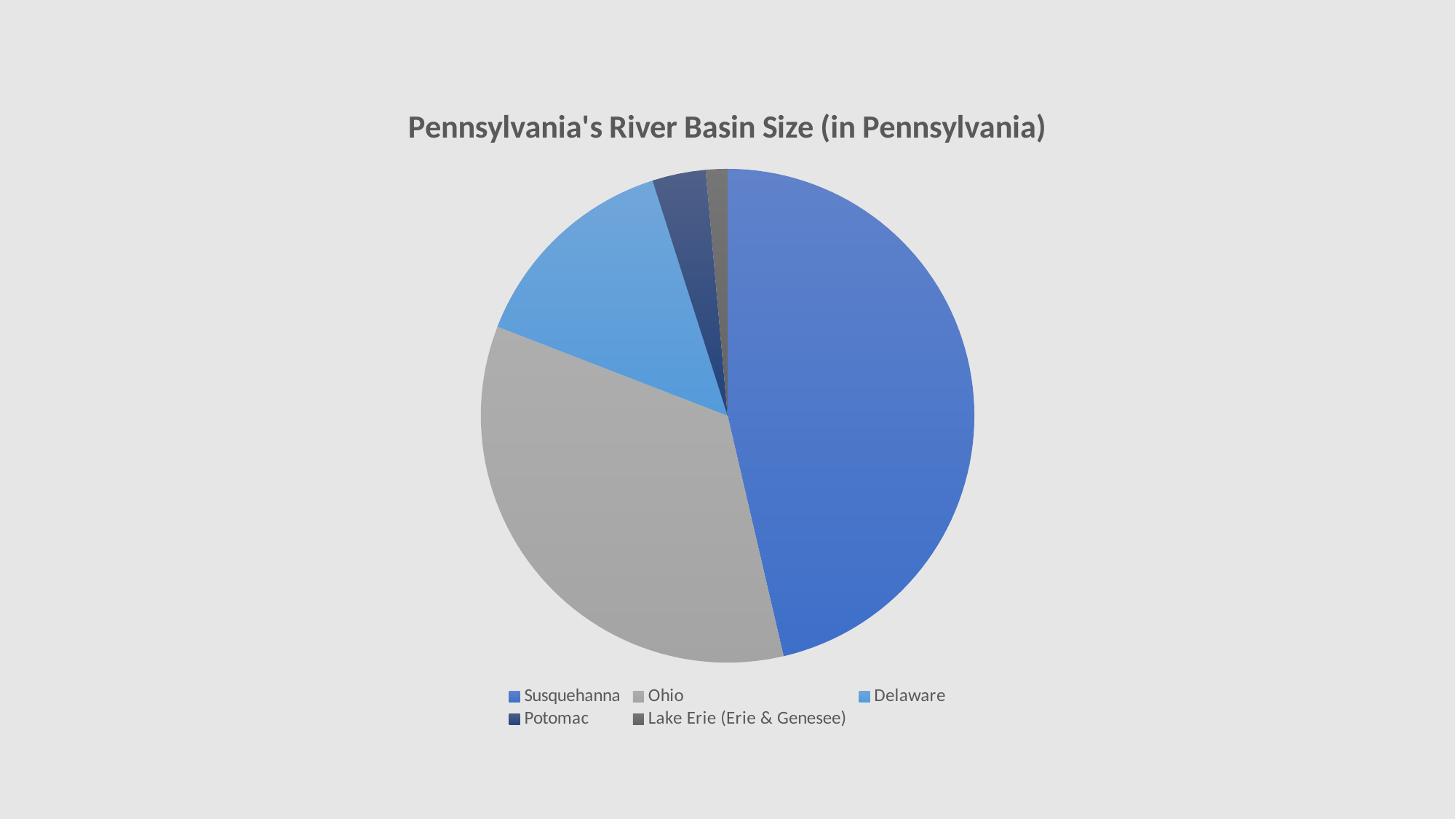
Which slice is larger, Susquehanna or Ohio? Susquehanna Which river basin has the largest slice of the pie? Susquehanna Which legend entry is shown in grey? Ohio What is the title of the chart? Pennsylvania's River Basin Size (in Pennsylvania) What kind of chart is shown on the slide? pie chart Which river basin has the second-largest slice of the pie? Ohio Which river basin has the smallest slice of the pie? Lake Erie (Erie & Genesee) Which slice is larger, Ohio or Delaware? Ohio Which slice is larger, Potomac or Lake Erie (Erie & Genesee)? Potomac How many slices does the pie chart have? 5